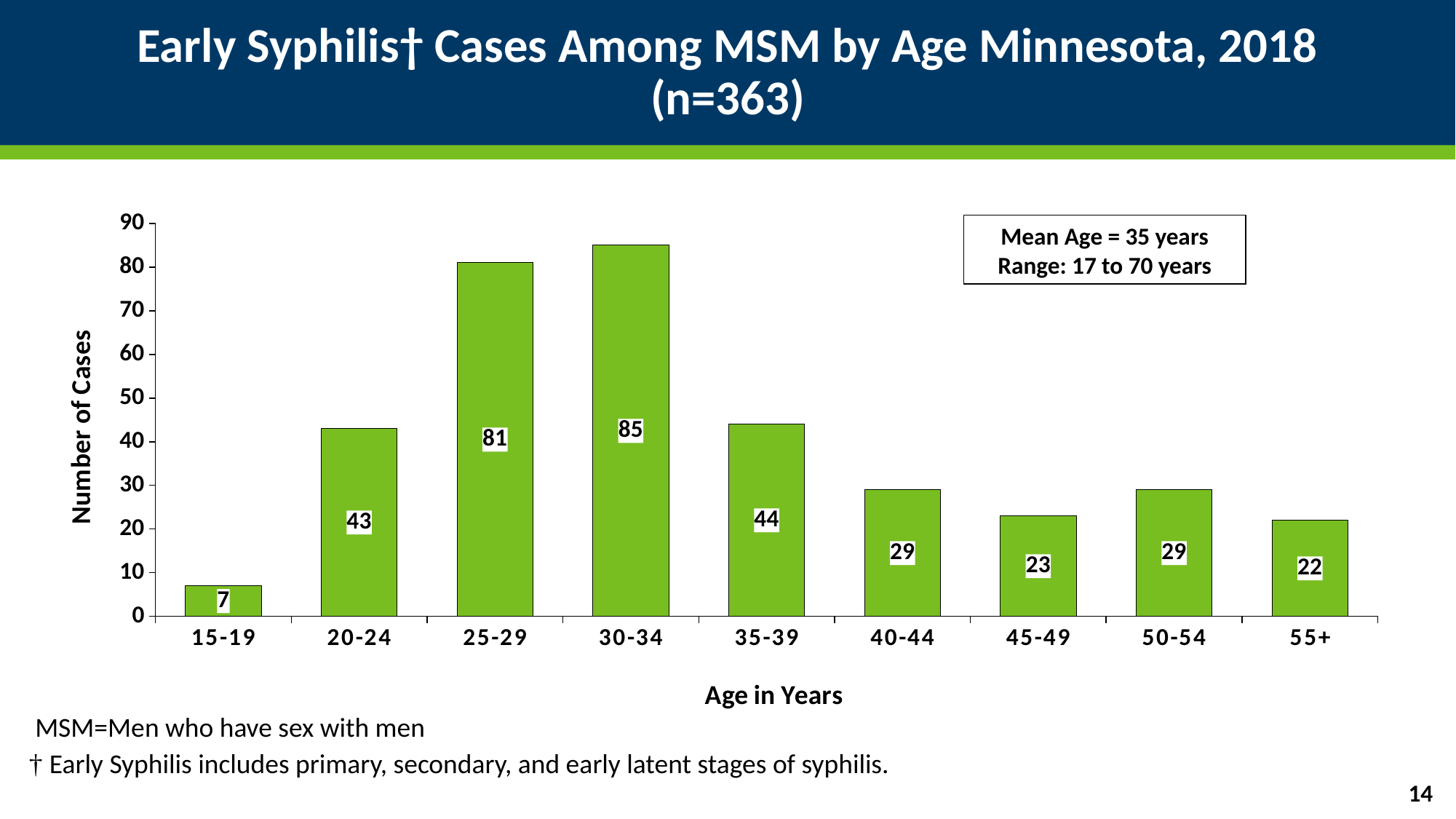
Which age group has the highest number of cases? 30-34 What is the difference in cases between the 35-39 and 45-49 age groups? 21 What is the number of cases for the 55+ age group? 22 How many early syphilis cases among MSM were in the 25-29 age group? 81 What is the difference in cases between the 30-34 and 25-29 age groups? 4 Is the value for the 40-44 age group greater or less than 30? less What mean age is stated in the box on the chart? 35 years Which age group has the lowest number of cases? 15-19 What kind of chart is shown on the slide? bar chart Which age group has more cases, 20-24 or 35-39? 35-39 How many age groups are shown on the x axis? 9 Do the values rise or fall from the 30-34 age group to the 45-49 age group? fall